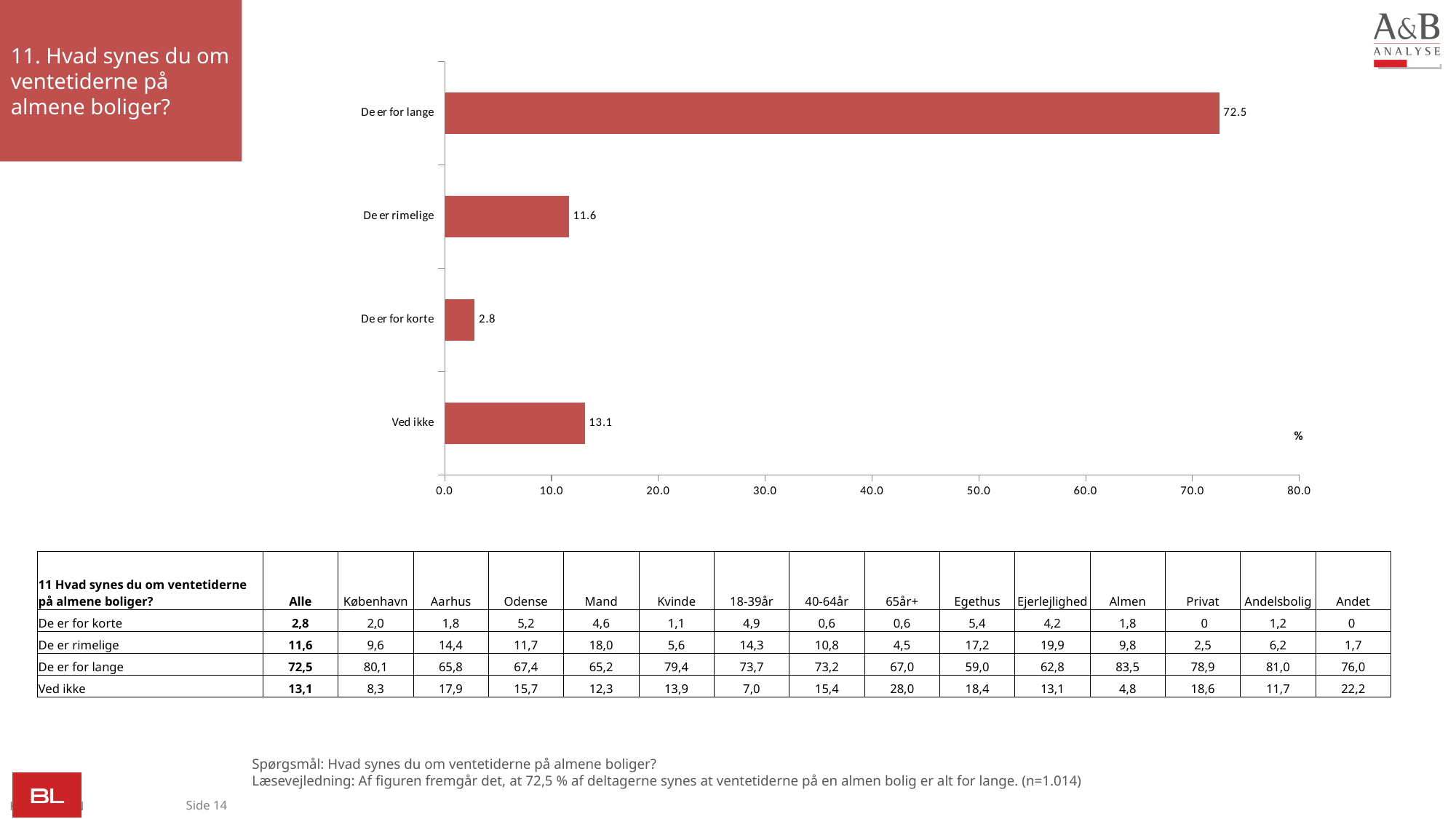
Is the value for "De er for lange" greater or less than 70.0? greater Which is larger, the value for "Ved ikke" or the value for "De er rimelige"? Ved ikke What is the value for "De er for korte"? 2.8 Which category has the lowest value? De er for korte What is the value for "De er rimelige"? 11.6 How many categories are shown in the chart? 4 Which category has the highest value? De er for lange What kind of chart is shown on the slide? bar chart What is the value for "Ved ikke"? 13.1 What is the value for "De er for lange"? 72.5 What is the difference between the values for "De er for lange" and "Ved ikke"? 59.4 What is the maximum value shown on the x axis of the chart? 80.0